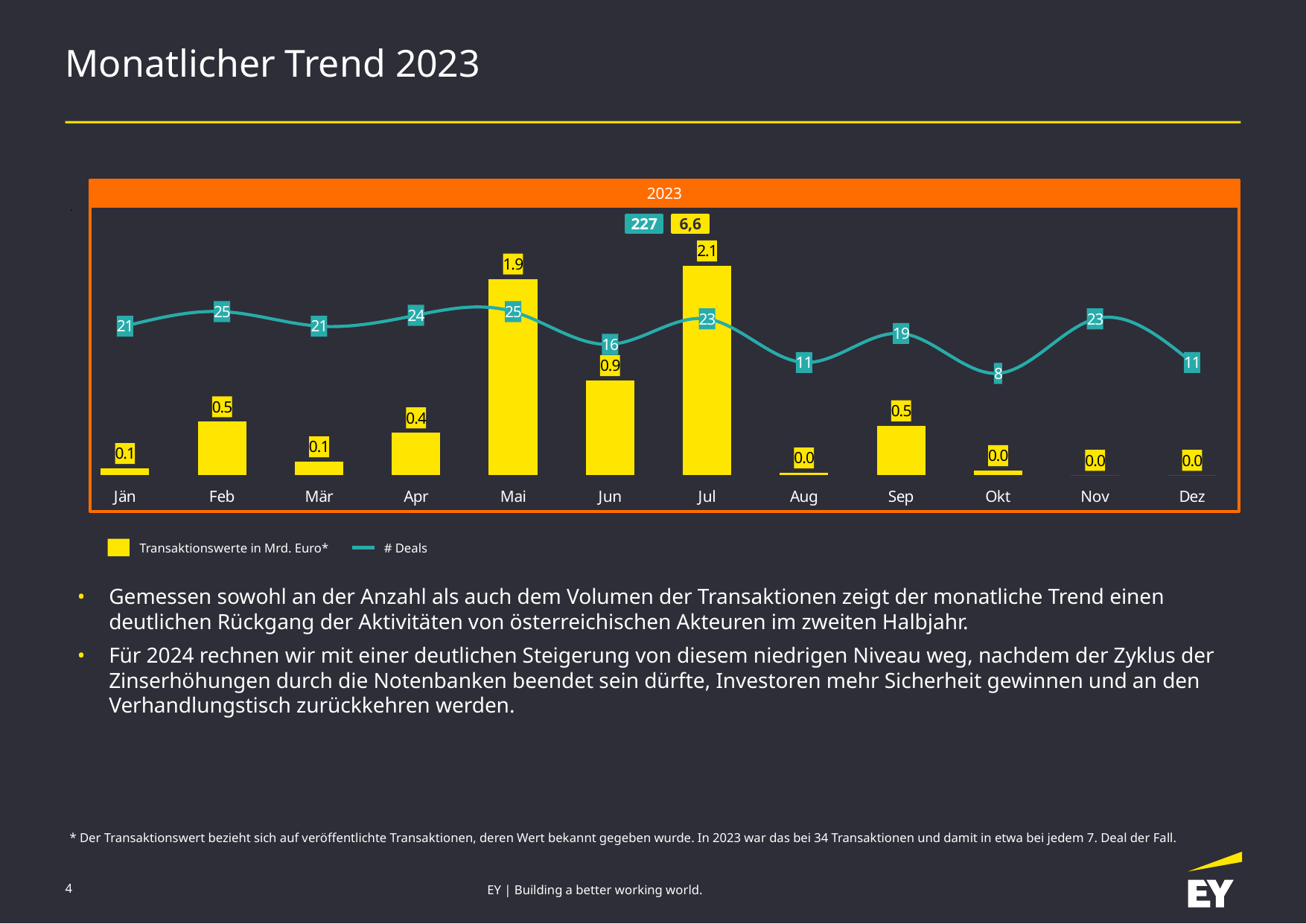
What is the difference in the number of deals between Feb and Jun? 9 Which month has the lowest number of deals? Okt What is the transaction value (Transaktionswerte in Mrd. Euro) for Jul? 2.1 What kind of chart is shown on the slide? Combined bar and line chart What total number of deals for 2023 is printed at the top of the chart? 227 Which month has more deals, Apr or Aug? Apr Which month has the highest transaction value? Jul What is the difference in transaction value between Jul and Mai? 0.2 What is the label of the bar series in the legend? Transaktionswerte in Mrd. Euro* How many deals (# Deals) are shown for Sep? 19 How many series does the legend list? 2 How many months are shown on the x axis of the chart? 12